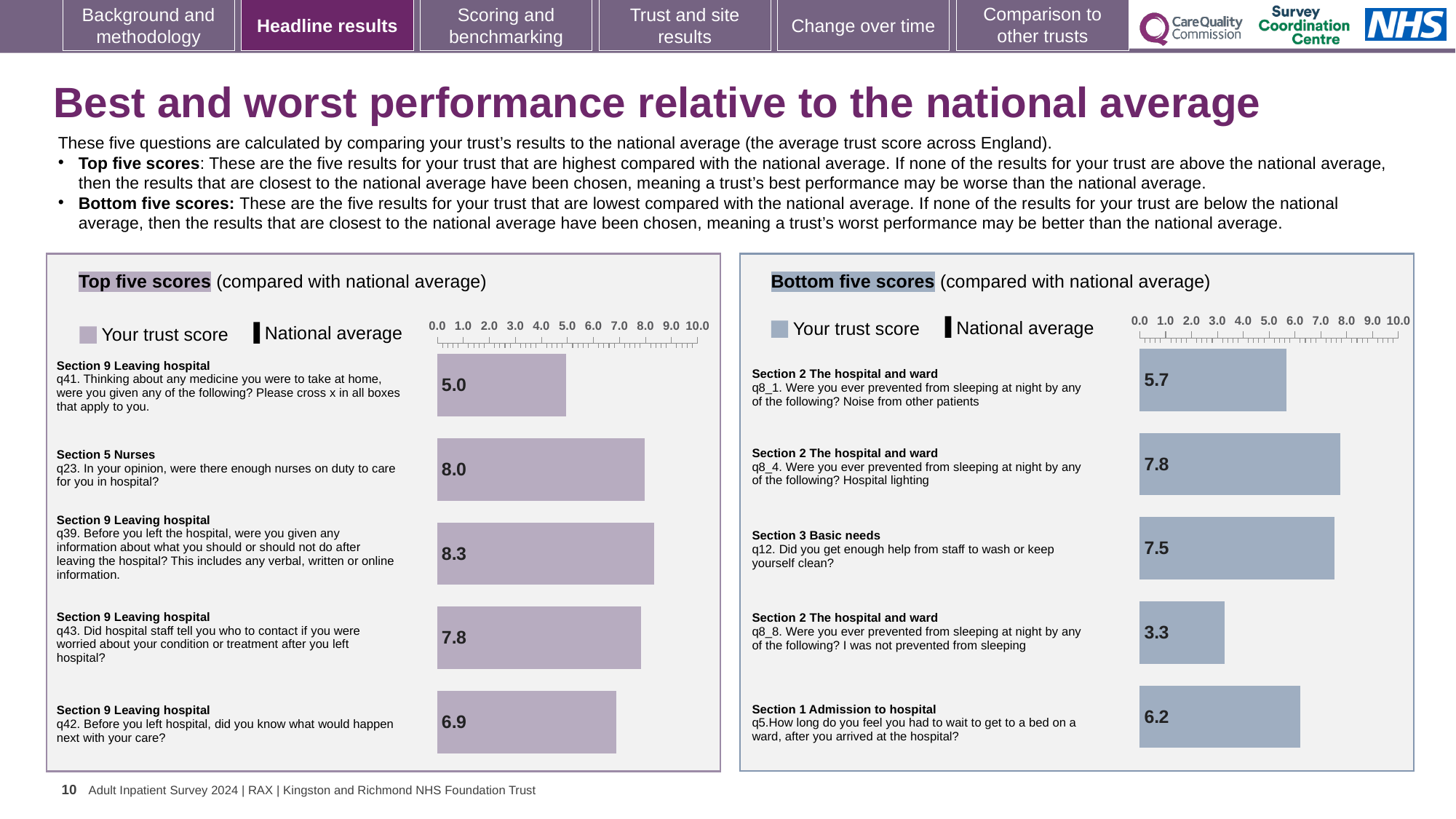
In the Bottom five scores chart, what is the trust score for q8_8 (I was not prevented from sleeping)? 3.3 In the Bottom five scores chart, which question has the highest trust score? q8_4 In the Top five scores chart, what is the trust score for q23 (enough nurses on duty)? 8.0 In the Top five scores chart, which question has the lowest trust score? q41 In the Bottom five scores chart, what is the trust score for q12 (enough help from staff to wash or keep yourself clean)? 7.5 How many questions are plotted in the Top five scores chart? 5 In the Top five scores chart, which question has the highest trust score? q39 In the Top five scores chart, what is the trust score for q42 (did you know what would happen next with your care)? 6.9 In the Top five scores chart, what is the difference between the scores for q39 and q41? 3.3 In the Bottom five scores chart, what is the difference between the scores for q8_4 and q8_8? 4.5 In the Bottom five scores chart, which is larger, the score for q8_1 or the score for q5? q5 What type of chart is the Bottom five scores chart? Bar chart